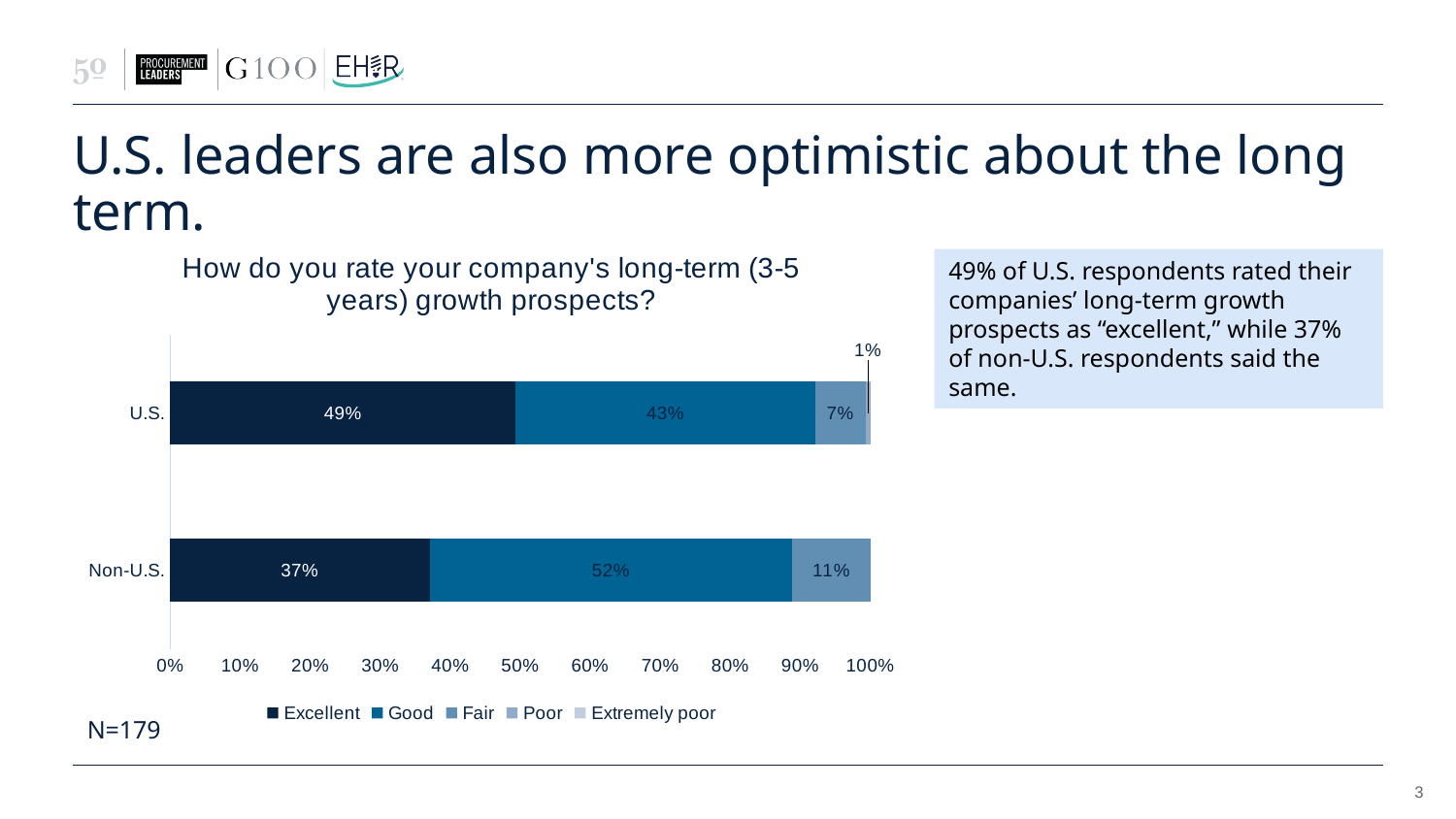
What is the Fair share for the U.S. bar? 7% How many series does the legend list? 5 What is the Fair share for the Non-U.S. bar? 11% Which group has the larger Excellent share, U.S. or Non-U.S.? U.S. What percentage of Non-U.S. respondents rated their long-term growth prospects as Good? 52% What is the Good share for the U.S. bar? 43% Which group has the larger Good share, U.S. or Non-U.S.? Non-U.S. What is the title of the chart? How do you rate your company's long-term (3-5 years) growth prospects? What kind of chart is shown on the slide? Stacked bar chart What percentage of U.S. respondents rated their long-term growth prospects as Excellent? 49% How many categories (groups) are shown on the chart? 2 What is the difference between the U.S. and Non-U.S. Excellent shares? 12%